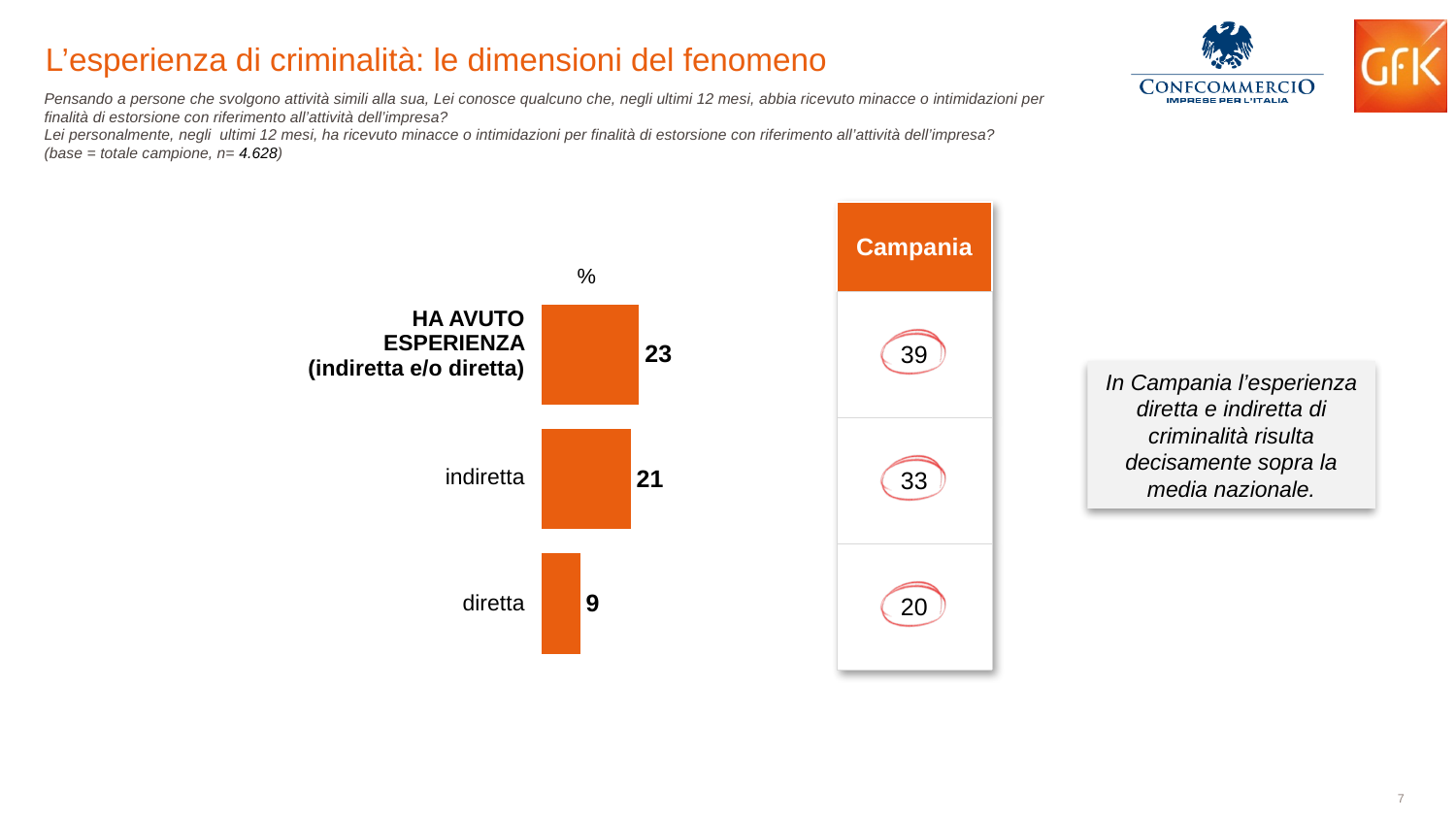
What is the value for 'HA AVUTO ESPERIENZA (indiretta e/o diretta)' in the bar chart? 23 Which category has the lowest value in the bar chart? diretta How many categories are shown in the bar chart? 3 What is the difference between the values for 'indiretta' and 'diretta' in the bar chart? 12 What unit label is shown above the bars in the chart? % What colour are the bars in the chart? orange What kind of chart is shown on the slide? bar chart What is the difference between the values for 'HA AVUTO ESPERIENZA (indiretta e/o diretta)' and 'indiretta' in the bar chart? 2 What is the value for 'indiretta' in the bar chart? 21 Which category has the highest value in the bar chart? HA AVUTO ESPERIENZA (indiretta e/o diretta) Which is larger in the bar chart, the value for 'indiretta' or the value for 'diretta'? indiretta What is the value for 'diretta' in the bar chart? 9